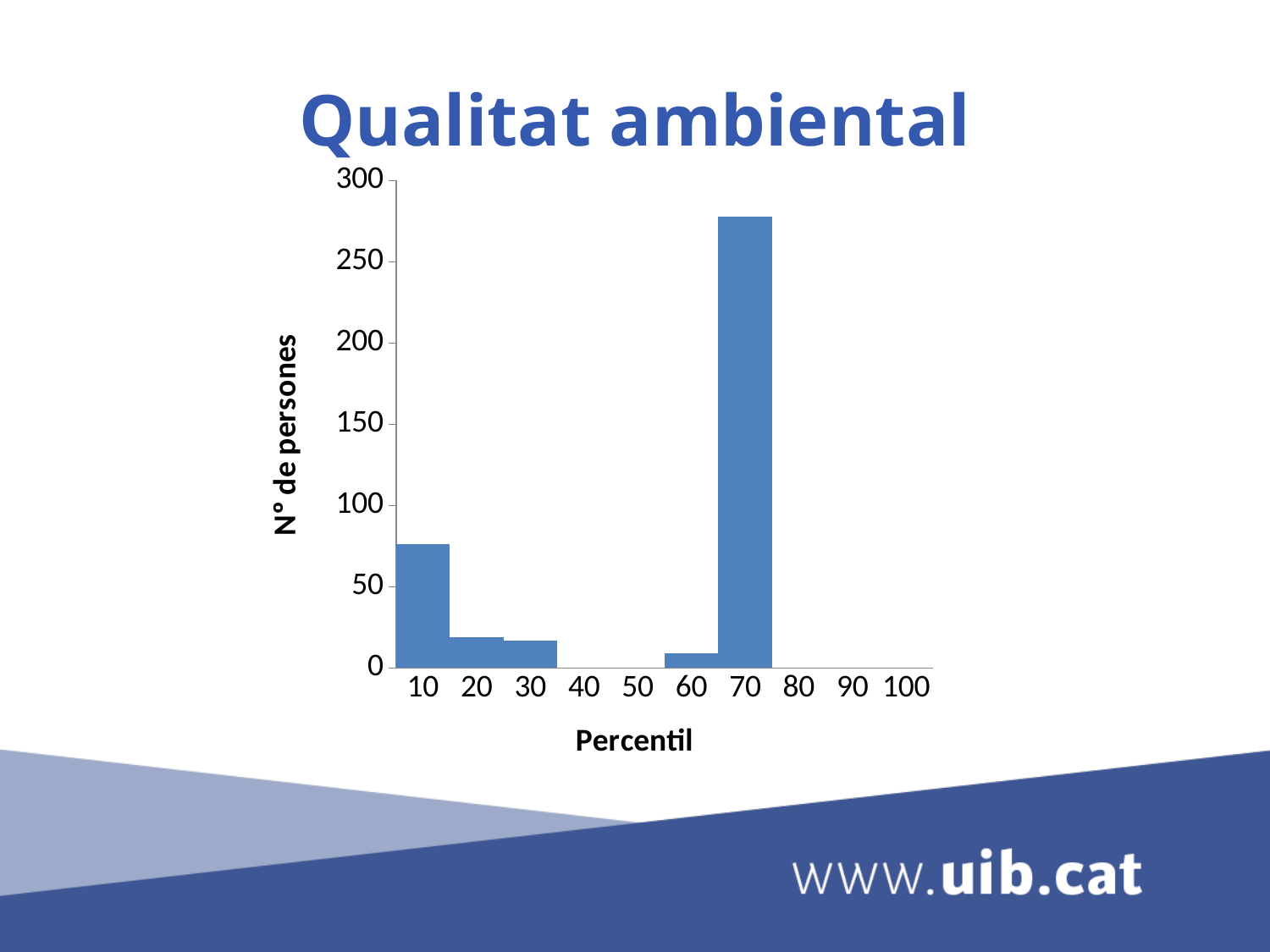
Is the value for percentil 20 greater or less than 50? less What kind of chart is shown on the slide? bar chart Which is larger, the value for percentil 10 or the value for percentil 20? percentil 10 Is the value for percentil 10 greater or less than 50? greater Which is larger, the value for percentil 70 or the value for percentil 60? percentil 70 What is the label of the y axis? Nº de persones How many percentil categories are shown on the x axis? 10 Is the value for percentil 10 greater or less than 100? less What is the title of the chart? Qualitat ambiental Which percentil category has the highest number of persones? 70